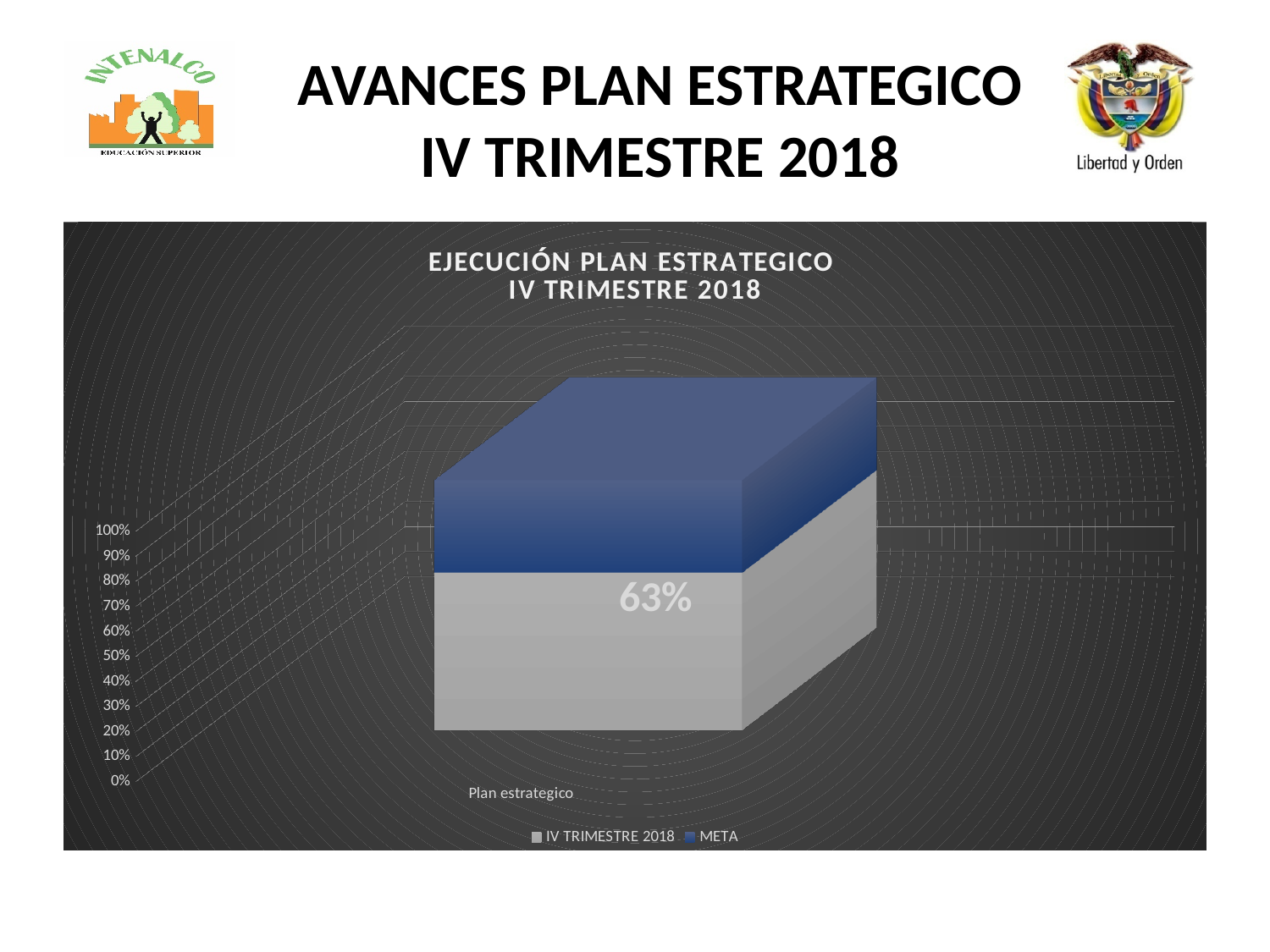
How many categories are plotted on the x axis? 1 Is the value for IV TRIMESTRE 2018 greater or less than 50%? greater What is the value of the IV TRIMESTRE 2018 series for Plan estrategico? 63% Is the value for IV TRIMESTRE 2018 greater or less than 70%? less How many series does the legend list? 2 What is the title of the chart? EJECUCIÓN PLAN ESTRATEGICO IV TRIMESTRE 2018 What kind of chart is shown on the slide? bar chart Which colour represents the META series in the chart? blue